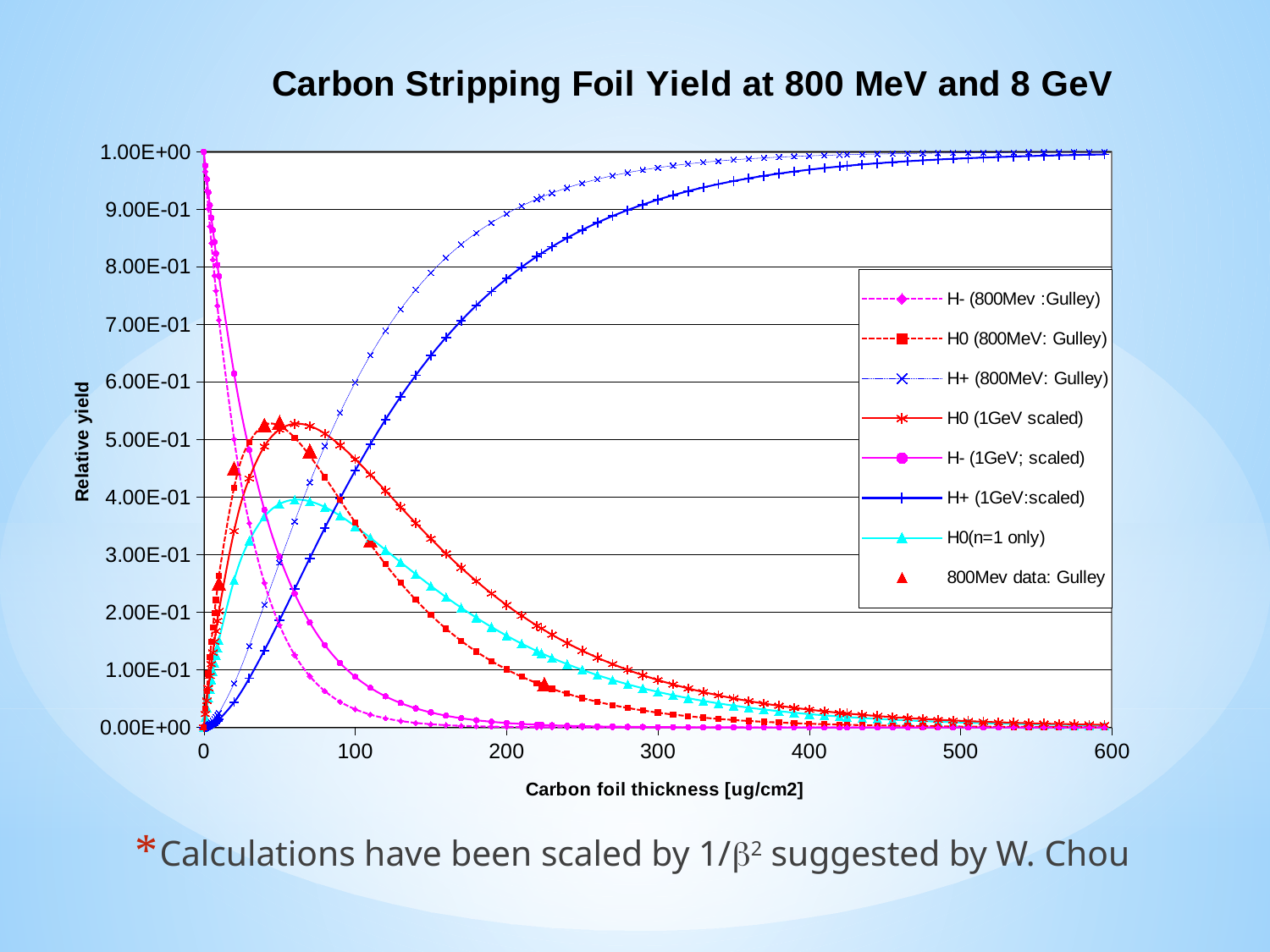
Is the peak value of H0 (1GeV scaled) greater or less than 5.00E-01? greater What is the label of the x axis? Carbon foil thickness [ug/cm2] Is the value of H- (1GeV; scaled) at a thickness of 200 greater or less than 1.00E-01? less What kind of chart is shown on the slide? line chart Is the value of H+ (1GeV:scaled) at a thickness of 300 greater or less than 8.00E-01? greater What is the title of the chart? Carbon Stripping Foil Yield at 800 MeV and 8 GeV At a thickness of 300, which is larger: H+ (1GeV:scaled) or H0 (1GeV scaled)? H+ (1GeV:scaled) Does the H- (1GeV; scaled) series rise or fall as carbon foil thickness increases beyond its starting point? fall How many series does the chart legend list? 8 At a thickness of 200, which is larger: H+ (800MeV: Gulley) or H+ (1GeV:scaled)? H+ (800MeV: Gulley) Does the H+ (1GeV:scaled) series rise or fall as carbon foil thickness increases? rise